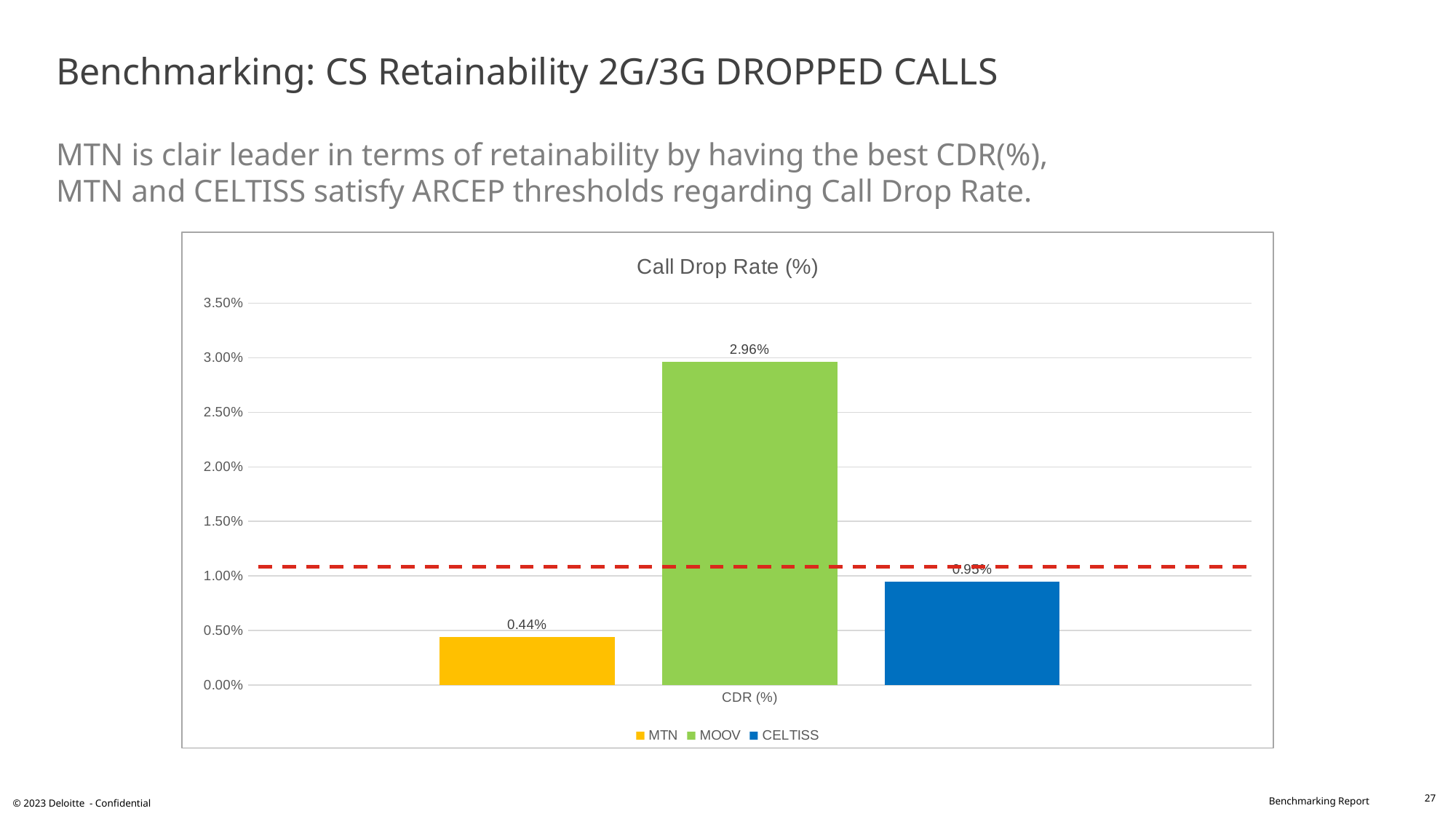
How many series does the legend list? 3 What is the difference between the Call Drop Rate of MOOV and MTN? 2.52% Is the Call Drop Rate for CELTISS greater or less than 1.00%? less What is the Call Drop Rate (%) value for MTN? 0.44% What kind of chart is shown on the slide? Bar chart Is the Call Drop Rate for MOOV greater or less than 2.50%? greater What is the Call Drop Rate (%) value for MOOV? 2.96% Which operator has the highest Call Drop Rate (%)? MOOV Which has a larger Call Drop Rate, CELTISS or MTN? CELTISS What colour is the bar for MOOV? Green What is the title of the chart? Call Drop Rate (%) Which operator has the lowest Call Drop Rate (%)? MTN